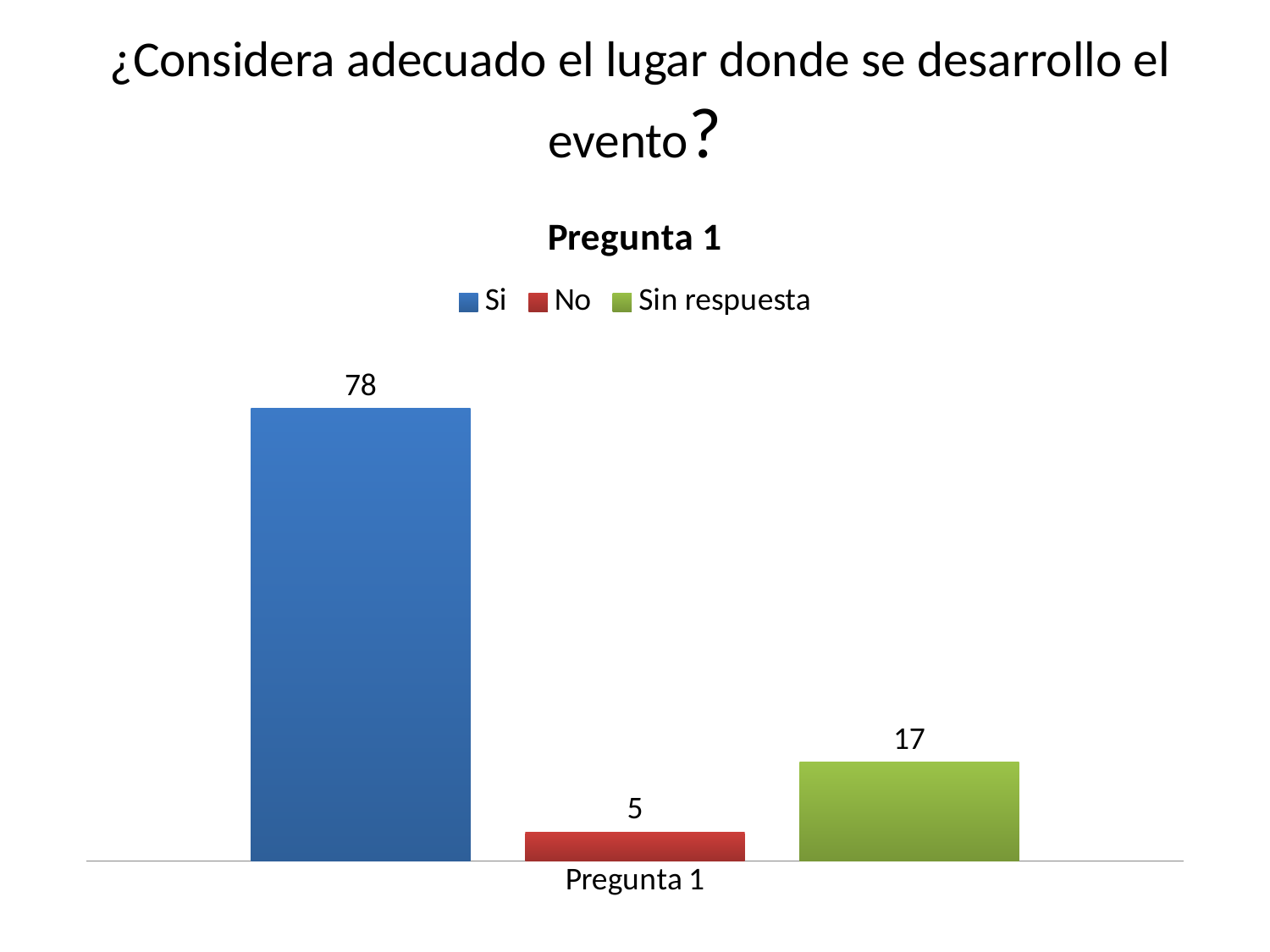
Which series has the highest value? Si What kind of chart is shown? bar chart What colour is the bar for Sin respuesta? green What is the value for Sin respuesta? 17 Which series has the lowest value? No What is the difference between the values for Si and Sin respuesta? 61 What is the value for Si? 78 What is the difference between the values for Sin respuesta and No? 12 Which is larger, the value for No or the value for Sin respuesta? Sin respuesta What is the title of the chart? Pregunta 1 What is the value for No? 5 How many series does the legend list? 3